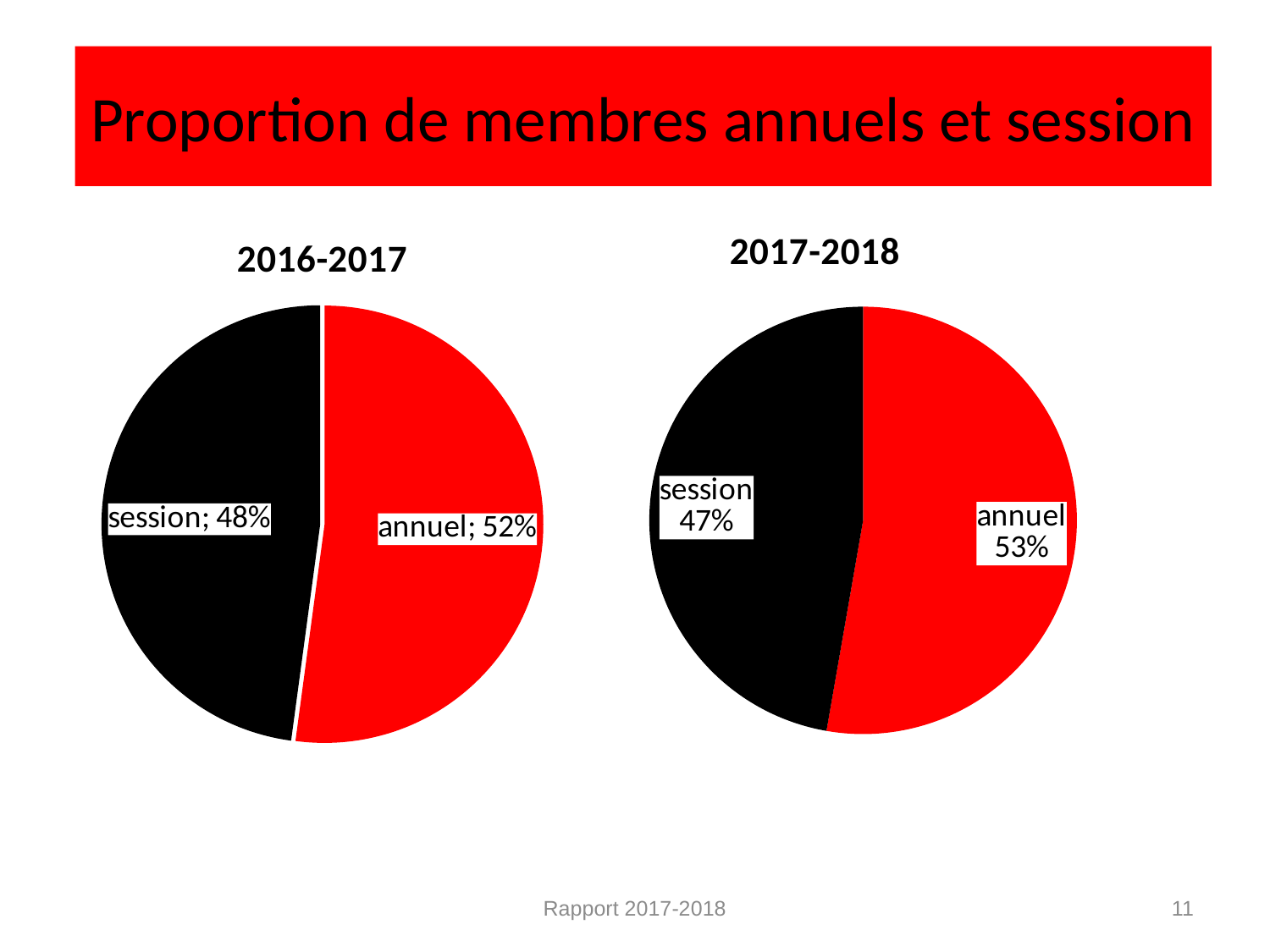
In the 2016-2017 chart, which category has the smallest slice? session How many slices does the 2017-2018 pie chart have? 2 In the 2017-2018 chart, which category has the largest slice? annuel In the 2016-2017 chart, what share of members are annuel members? 52% What kind of chart is the 2016-2017 chart? pie chart In the 2017-2018 chart, what share of members are annuel members? 53% In the 2017-2018 chart, what share of members are session members? 47% Which is larger: the annuel share in 2016-2017 or the annuel share in 2017-2018? 2017-2018 In the 2016-2017 chart, what colour is the annuel slice? red In the 2016-2017 chart, what is the difference in percentage points between annuel and session? 4 In the 2017-2018 chart, what is the difference in percentage points between annuel and session? 6 In the 2016-2017 chart, what share of members are session members? 48%